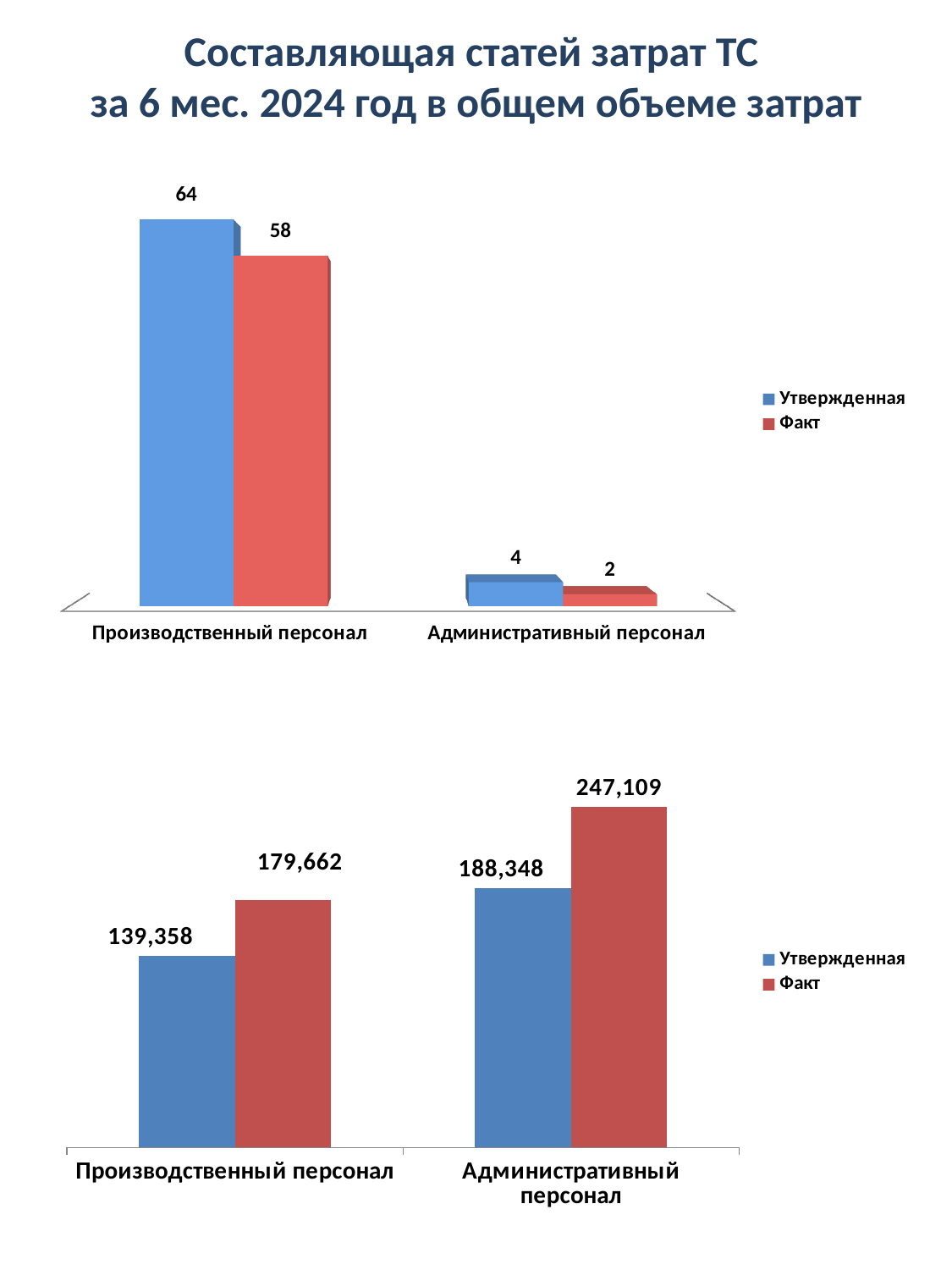
In the top chart, what is the value of Утвержденная for Производственный персонал? 64 In the top chart, how many series does the legend list? 2 In the top chart, what is the difference between Утвержденная and Факт for Производственный персонал? 6 In the bottom chart, what is the value of Факт for Административный персонал? 247,109 In the top chart, what is the value of Факт for Административный персонал? 2 In the bottom chart, what is the difference between Факт and Утвержденная for Административный персонал? 58,761 How many categories are shown on the x axis of the top chart? 2 In the bottom chart, what is the value of Утвержденная for Производственный персонал? 139,358 In the bottom chart, which is larger for Производственный персонал: Утвержденная or Факт? Факт In the top chart, which category has the highest Факт value? Производственный персонал What kind of chart is the bottom chart? Bar chart In the bottom chart, which category has the lowest Утвержденная value? Производственный персонал